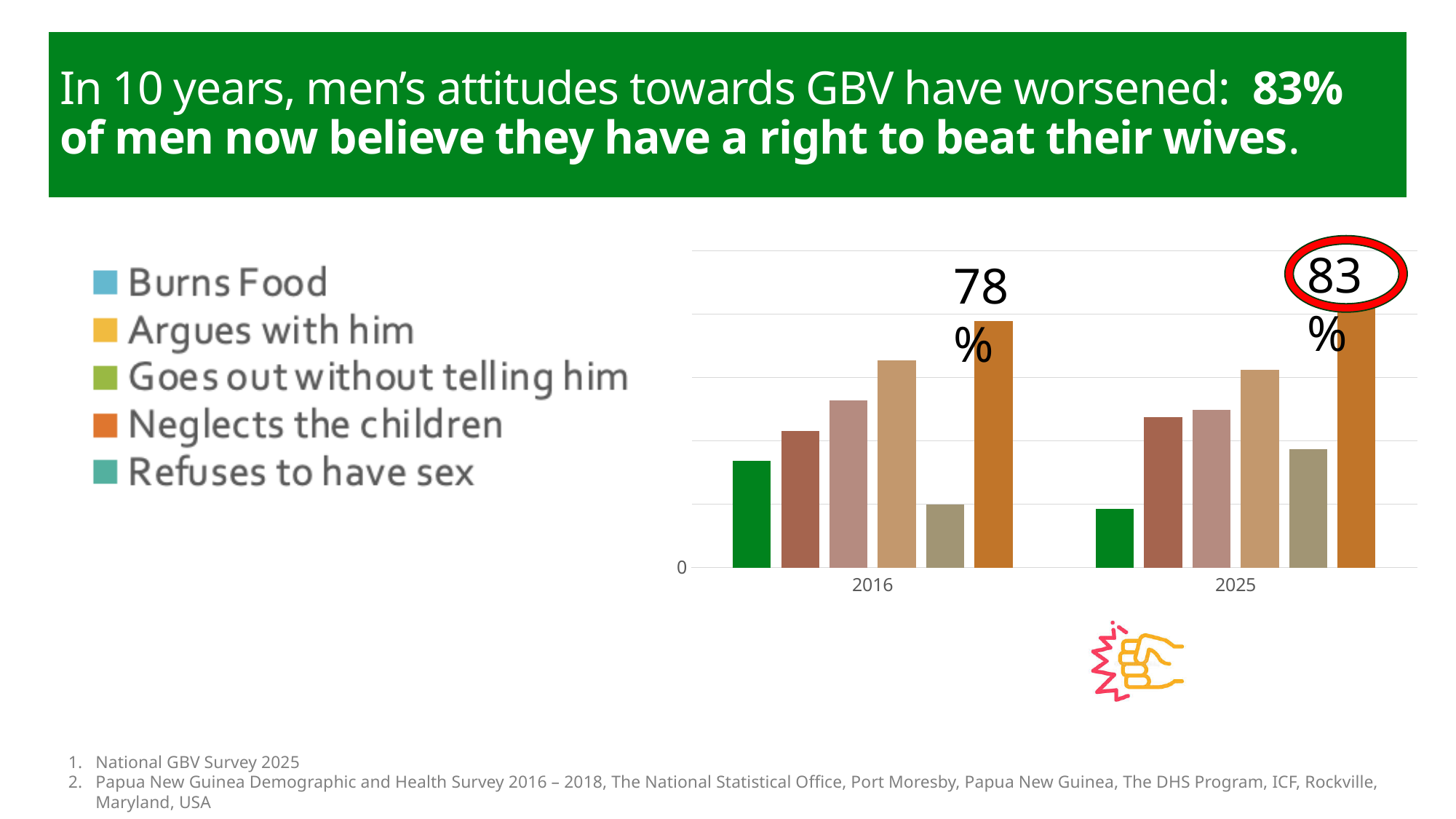
What is the data label on the tallest bar in the 2025 group? 83% How many year groups are shown on the x axis of the chart? 2 Does the labelled (orange) series rise or fall from 2016 to 2025? rises Which data label on the chart is circled in red? 83% In the 2025 group, which bar is the shortest? the green (first) bar What kind of chart is shown on the slide? bar chart How many entries does the legend on the left of the slide list? 5 How many bars are in each year group of the chart? 6 What is the difference between the labelled values for 2025 (83%) and 2016 (78%)? 5% What is the data label on the tallest bar in the 2016 group? 78% Which year has the higher labelled value, 2016 or 2025? 2025 Is the green bar for 2016 taller or shorter than the green bar for 2025? taller